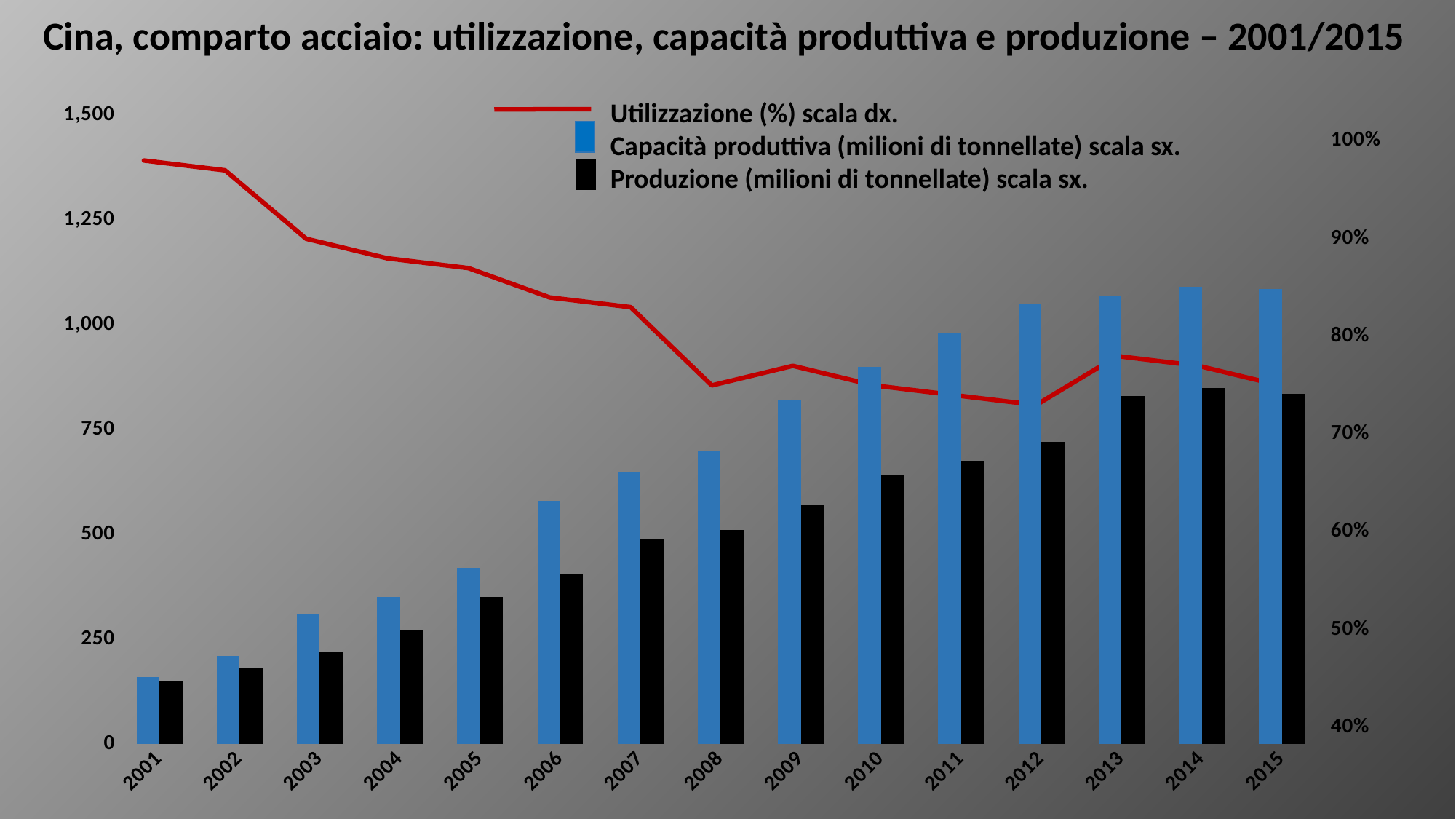
In which year is the Utilizzazione (%) line at its highest? 2001 Is the Capacità produttiva value for 2012 greater or less than 1,000? greater In which year is the Produzione bar the lowest? 2001 In which year is the Capacità produttiva bar the highest? 2014 Is the Utilizzazione (%) value for 2013 greater or less than 80%? less How many series does the legend list? 3 Is the Produzione value for 2012 greater or less than 750? less Does the Capacità produttiva series generally rise or fall from 2001 to 2015? rise Which is larger in 2009, Capacità produttiva or Produzione? Capacità produttiva How many years are shown along the x axis? 15 What kind of chart is shown on the slide? A combined bar and line chart Which series is drawn as a red line? Utilizzazione (%) scala dx.